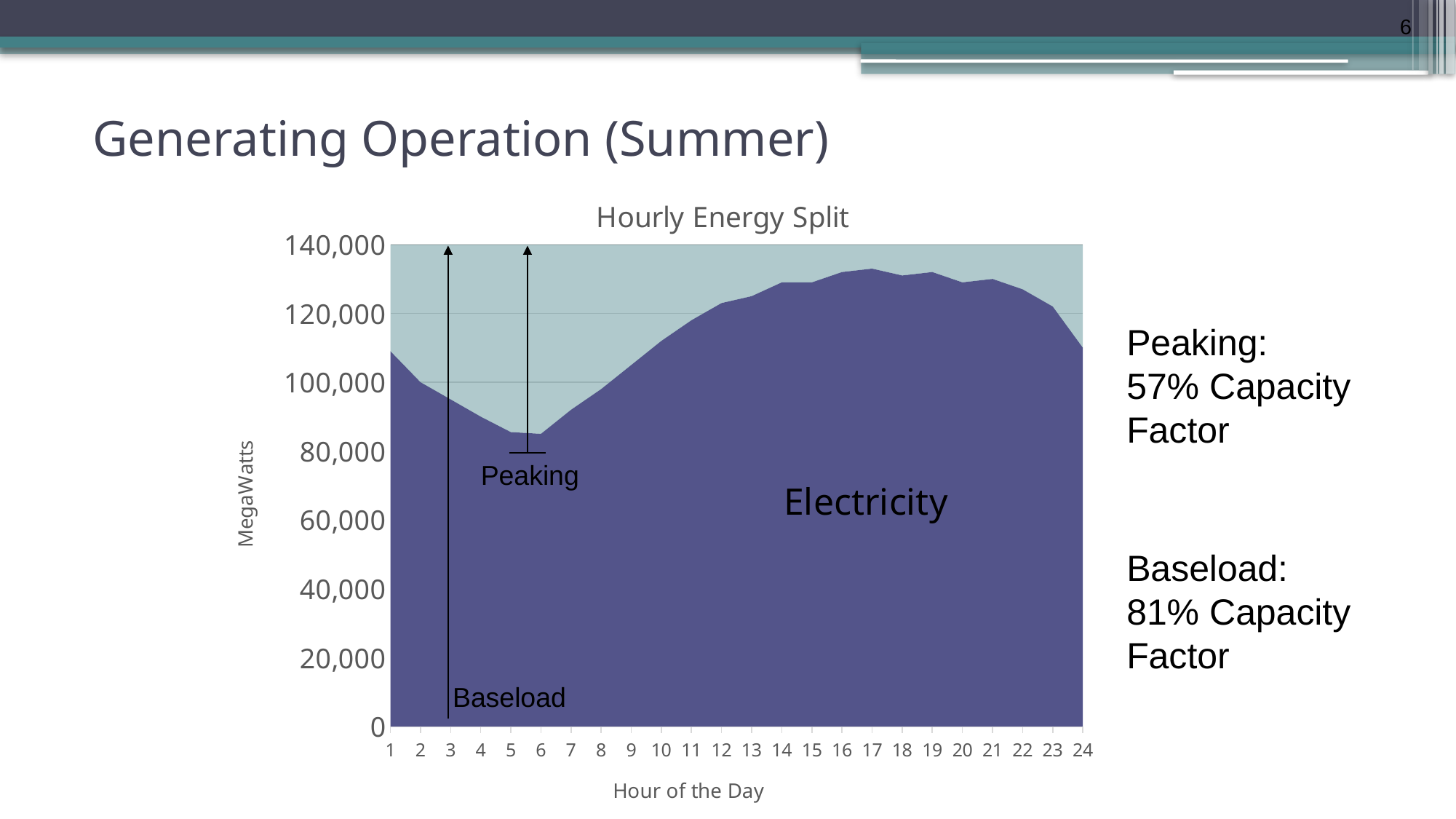
Which has the larger value, hour 17 or hour 5? Hour 17 Is the value for hour 17 greater or less than 120,000? greater What kind of chart is shown on the slide? Area chart Is the value for hour 24 greater or less than 100,000? greater Do the values rise or fall from hour 1 to hour 5? Fall How many hours are plotted along the x axis of the chart? 24 Is the value for hour 5 greater or less than 100,000? less What is the title of the chart? Hourly Energy Split Do the values rise or fall from hour 6 to hour 17? Rise What is the label on the vertical axis of the chart? MegaWatts